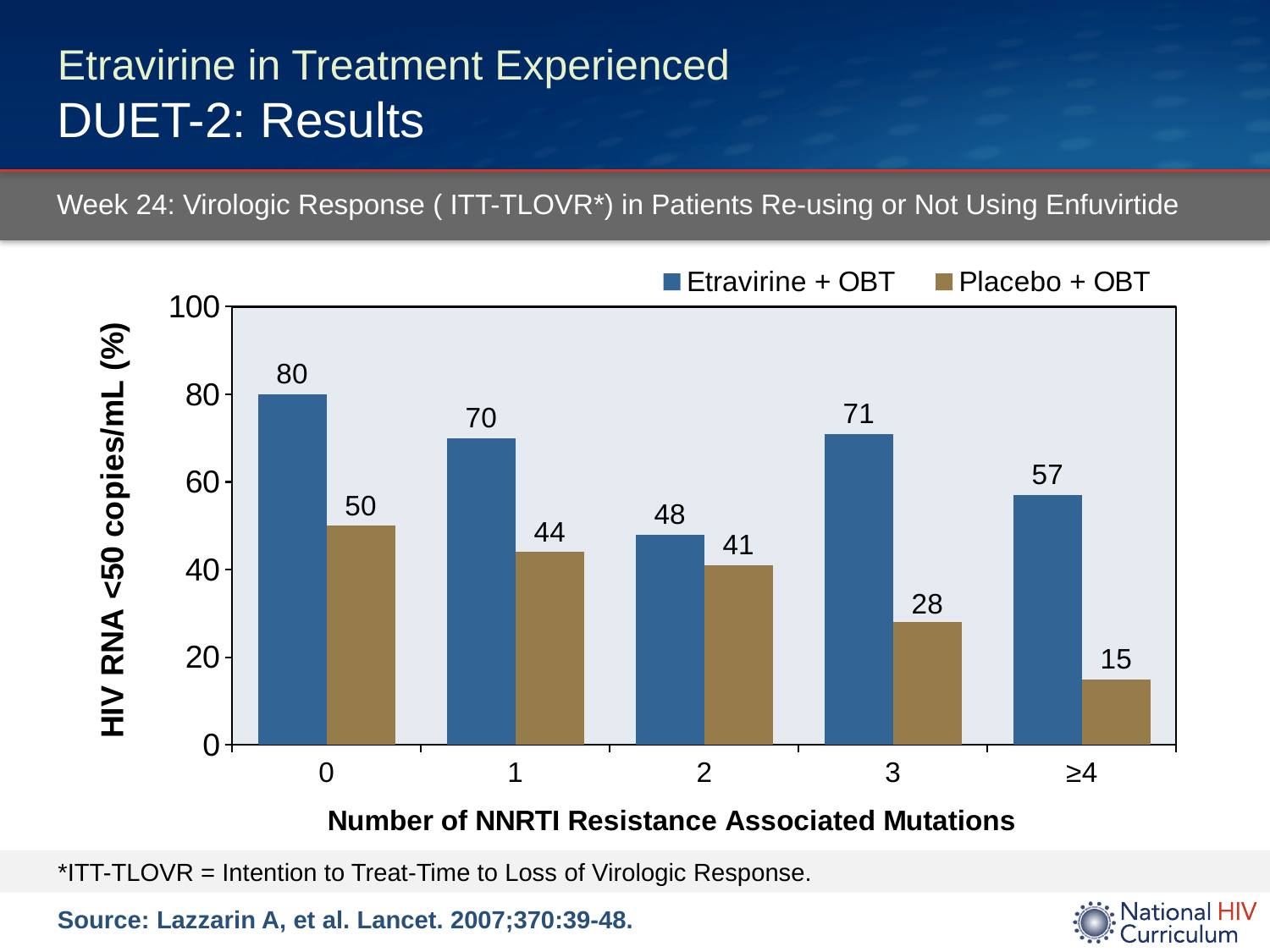
What is the value for Etravirine + OBT at ≥4 NNRTI resistance associated mutations? 57 What is the label of the y axis? HIV RNA <50 copies/mL (%) What is the value for Etravirine + OBT at 0 NNRTI resistance associated mutations? 80 What is the difference between Etravirine + OBT and Placebo + OBT at 2 mutations? 7 What is the value for Placebo + OBT at 3 NNRTI resistance associated mutations? 28 Which mutation category has the lowest value for Placebo + OBT? ≥4 What kind of chart is shown on the slide? Bar chart How many series does the legend list? 2 What is the difference between Etravirine + OBT and Placebo + OBT at 3 mutations? 43 Which is larger at 1 mutation: Etravirine + OBT or Placebo + OBT? Etravirine + OBT Which mutation category has the highest value for Etravirine + OBT? 0 How many mutation categories are shown on the x axis? 5